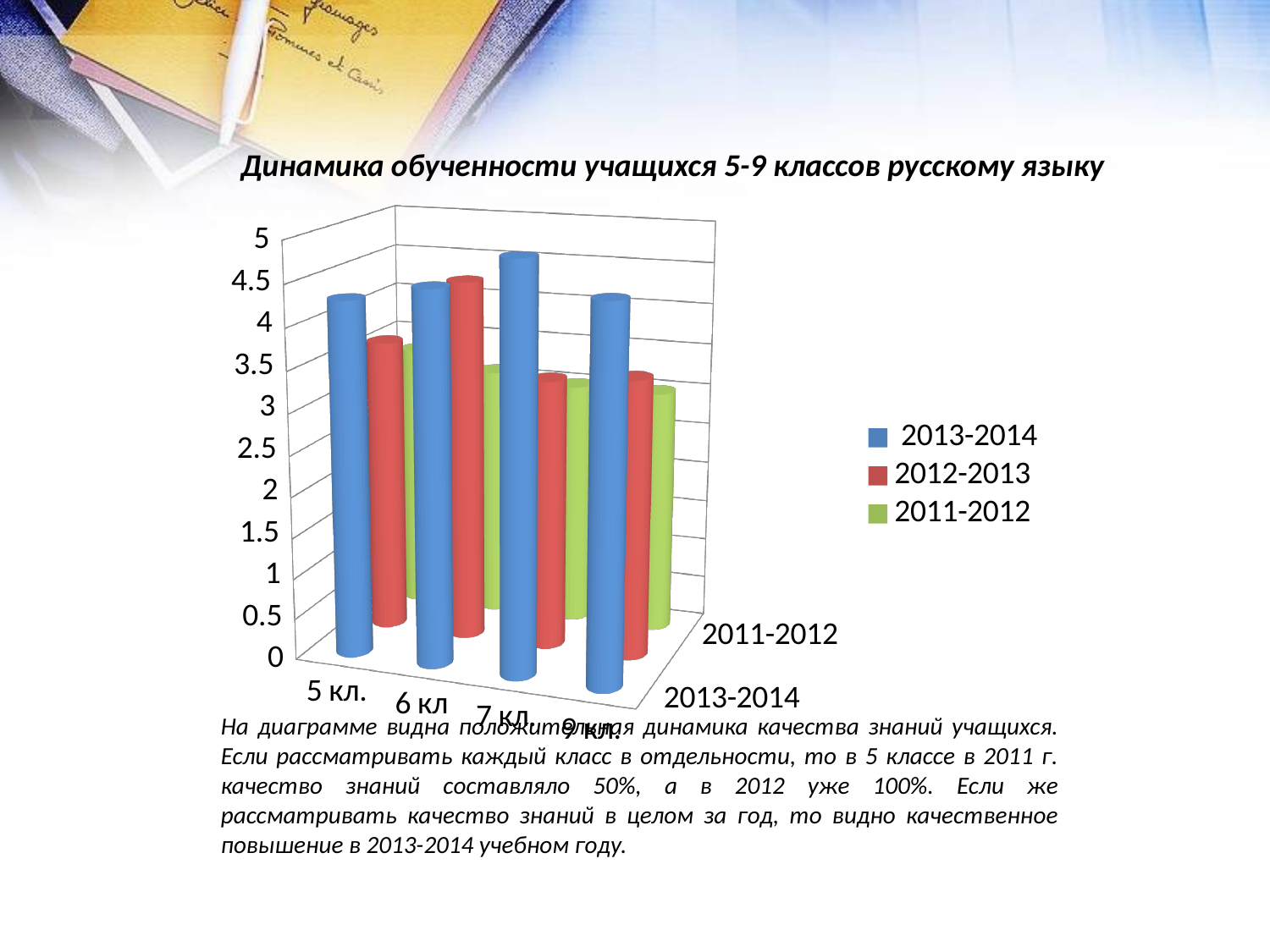
For 5 кл., which series has the larger value: 2013-2014 or 2011-2012? 2013-2014 For 7 кл., which series has the larger value: 2013-2014 or 2012-2013? 2013-2014 How many series does the legend list? 3 For the 2013-2014 series, which class has the highest value? 7 кл. Is the 2012-2013 value for 7 кл. greater or less than 4? less Is the 2013-2014 value for 7 кл. greater or less than 4? greater What is the title of the chart? Динамика обученности учащихся 5-9 классов русскому языку What kind of chart is shown on the slide? bar chart How many class categories are plotted along the x axis? 4 Is the 2012-2013 value for 6 кл greater or less than 4? greater For the 2012-2013 series, which class has the highest value? 6 кл Which series is listed first in the legend? 2013-2014